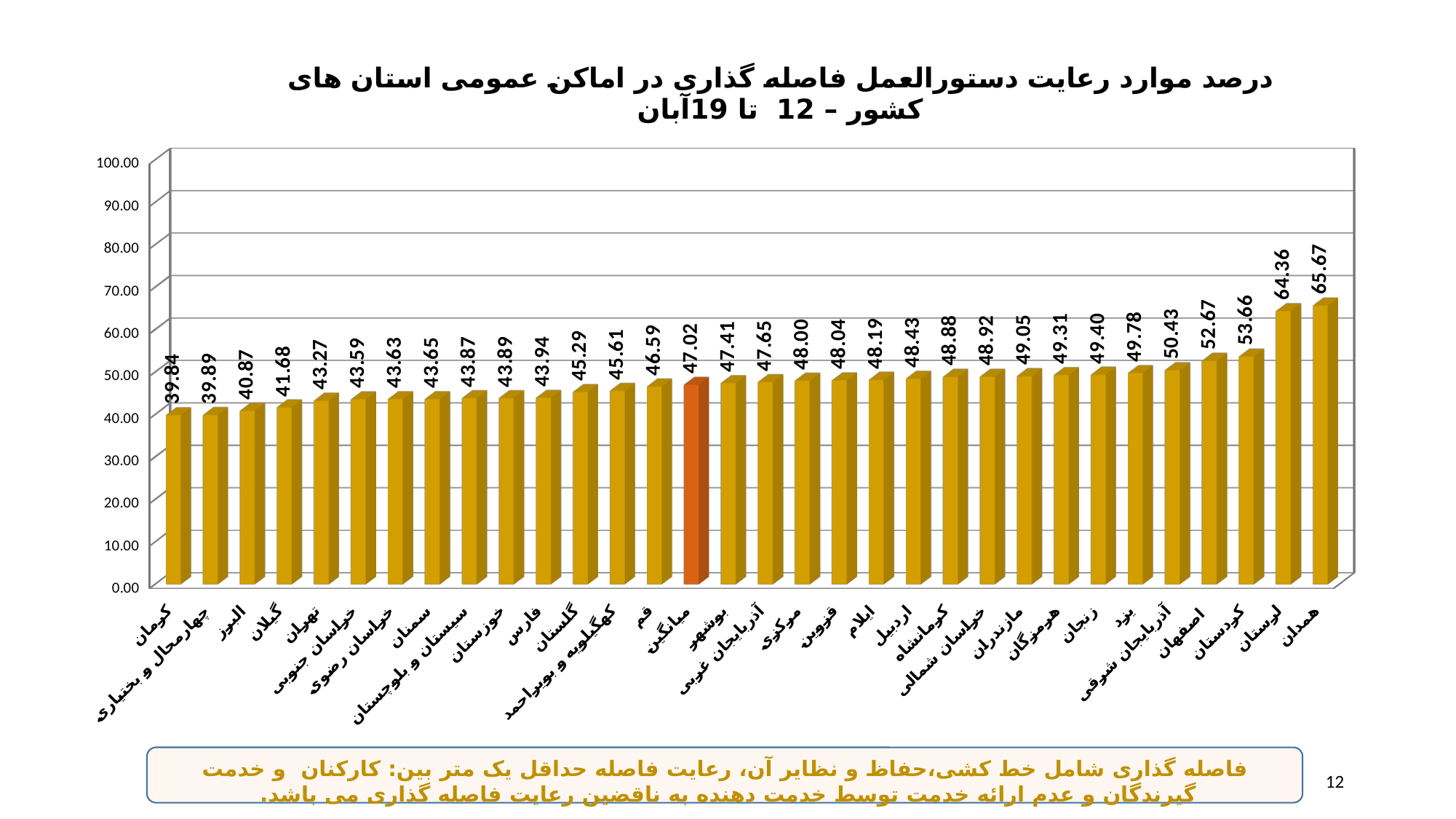
What is the difference between the values for همدان and لرستان? 1.31 What is the value for تهران? 43.27 Is the value for لرستان greater or less than 60.00? greater What is the value shown for میانگین (the average bar)? 47.02 Which bar is shown in a different colour (orange) from the others? میانگین Do the values rise or fall from left to right along the x axis? rise Which is larger, the value for اصفهان or the value for کردستان? کردستان What kind of chart is shown on the slide? bar chart How many bars are plotted in the chart? 32 What is the value for همدان? 65.67 Which category has the highest value? همدان Which category has the lowest value? کرمان